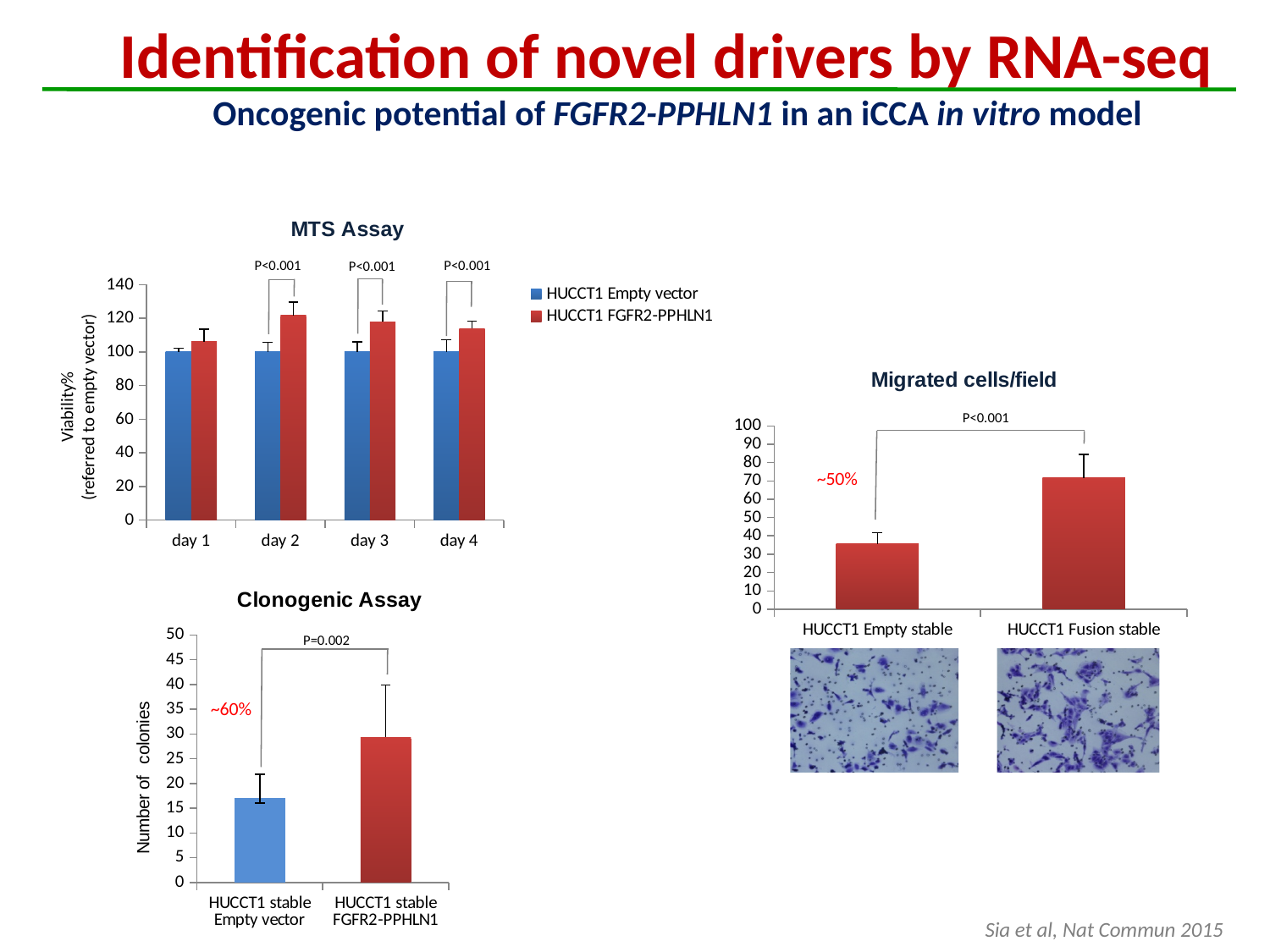
In the Clonogenic Assay chart, which category has the highest number of colonies? HUCCT1 stable FGFR2-PPHLN1 In the Clonogenic Assay chart, is the value for HUCCT1 stable FGFR2-PPHLN1 greater or less than 25? greater What P value is annotated between the two bars in the Clonogenic Assay chart? P=0.002 In the MTS Assay chart, which series has the larger value on day 2, HUCCT1 Empty vector or HUCCT1 FGFR2-PPHLN1? HUCCT1 FGFR2-PPHLN1 In the Clonogenic Assay chart, is the value for HUCCT1 stable Empty vector greater or less than 20? less How many series does the legend of the MTS Assay chart list? 2 How many categories are shown on the x axis of the MTS Assay chart? 4 In the MTS Assay chart, what is the viability value for HUCCT1 Empty vector on day 1? 100 What type of chart is the MTS Assay chart? bar chart In the Migrated cells/field chart, which category has the lowest value? HUCCT1 Empty stable In the Migrated cells/field chart, is the value for HUCCT1 Fusion stable greater or less than 60? greater